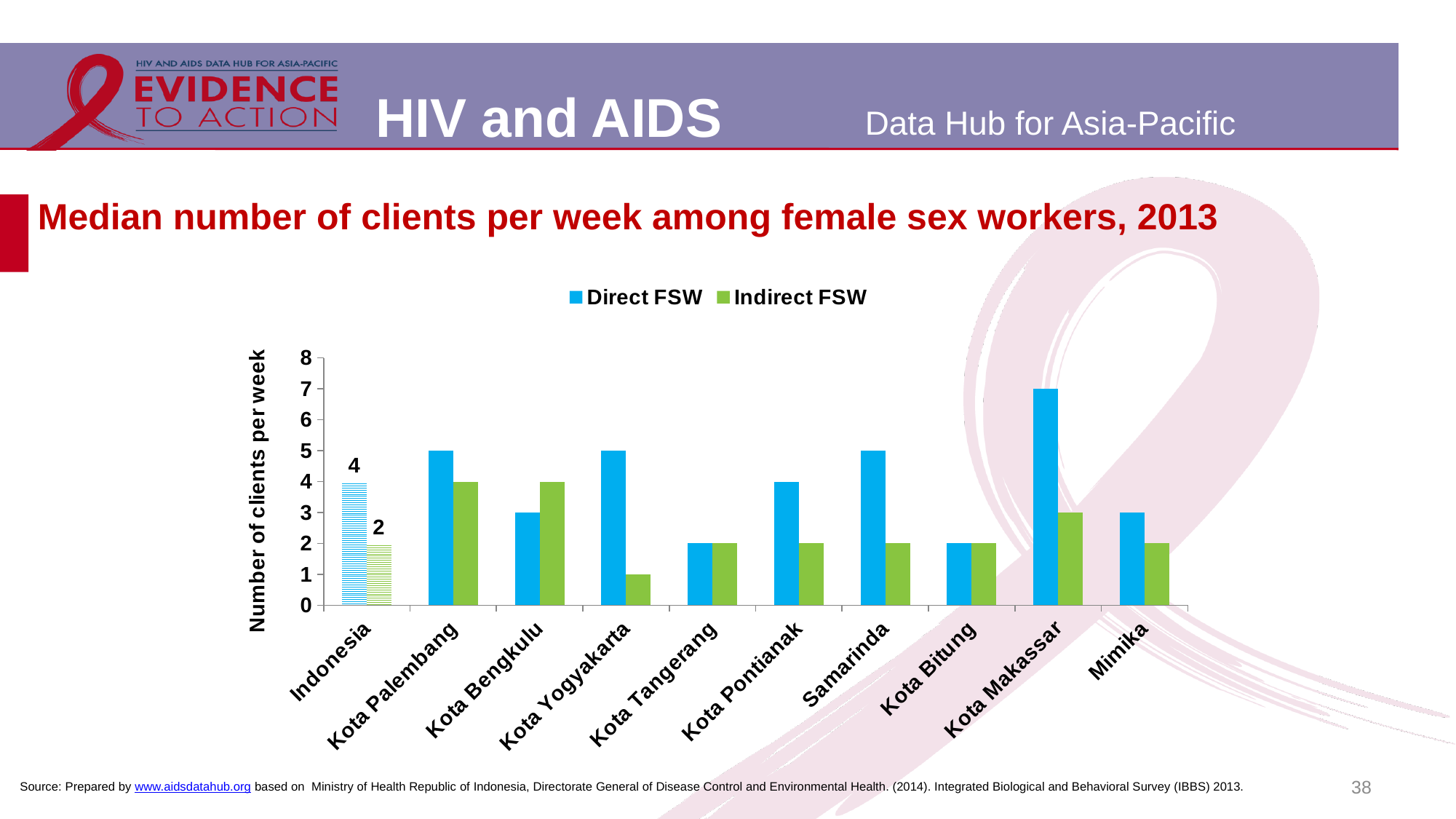
What is the median number of clients per week for Indirect FSW in Indonesia? 2 What kind of chart is shown on the slide? Bar chart What is the difference between the Direct FSW and Indirect FSW values for Indonesia? 2 Is the value for Direct FSW in Kota Makassar greater or less than 6? greater What is the value for Direct FSW in Kota Makassar? 7 How many series does the legend list? 2 Which is larger in Kota Bengkulu, the Direct FSW value or the Indirect FSW value? Indirect FSW What is the median number of clients per week for Direct FSW in Indonesia? 4 Which location has the lowest value for Indirect FSW? Kota Yogyakarta Which location has the highest value for Direct FSW? Kota Makassar How many locations are shown on the x axis? 10 What is the value for Indirect FSW in Kota Yogyakarta? 1